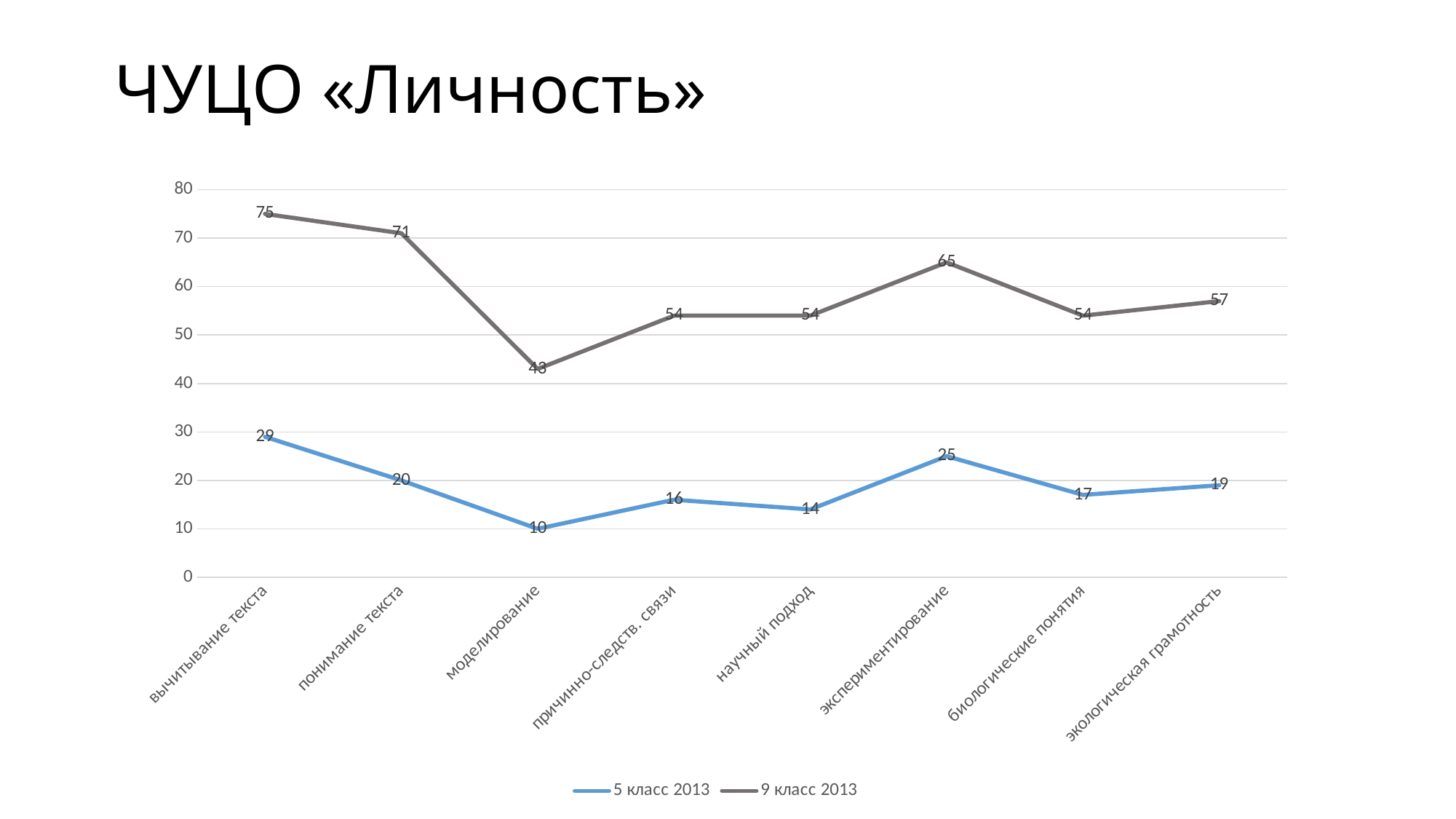
How many series does the legend list? 2 What is the value for 9 класс 2013 for экологическая грамотность? 57 What is the difference between 9 класс 2013 and 5 класс 2013 for вычитывание текста? 46 What is the value for 9 класс 2013 for моделирование? 43 Does the 5 класс 2013 series rise or fall from вычитывание текста to моделирование? fall Which is larger for 5 класс 2013: понимание текста or биологические понятия? понимание текста What colour is the line for 5 класс 2013? blue What type of chart is shown on the slide? line chart How many categories are shown on the x axis? 8 Which category has the lowest value for 5 класс 2013? моделирование Which category has the highest value for 9 класс 2013? вычитывание текста What is the value for 5 класс 2013 for экспериментирование? 25